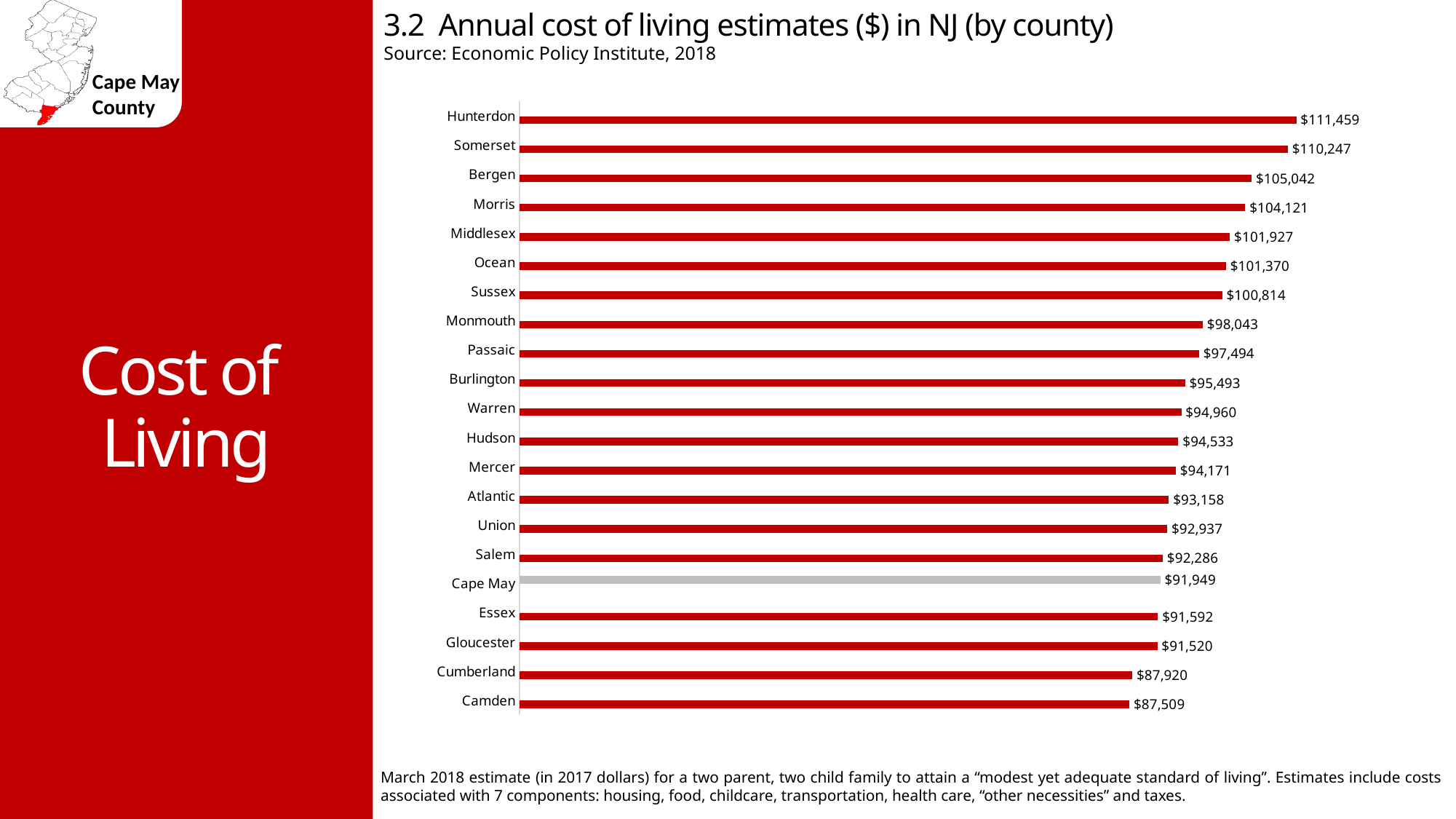
Which county has a higher cost of living estimate, Bergen or Morris? Bergen What is the annual cost of living estimate for Hunterdon county? $111,459 What is the difference between the cost of living estimates for Hunterdon and Camden? $23,950 What type of chart is used on this slide? Bar chart Which county's bar is shown in gray instead of red? Cape May Which county has the lowest annual cost of living estimate? Camden What is the difference between the cost of living estimates for Salem and Cape May? $337 Which county has a higher cost of living estimate, Cumberland or Gloucester? Gloucester What is the annual cost of living estimate for Atlantic county? $93,158 What is the annual cost of living estimate for Cape May county? $91,949 Which county has the highest annual cost of living estimate? Hunterdon How many counties are shown in the chart? 21